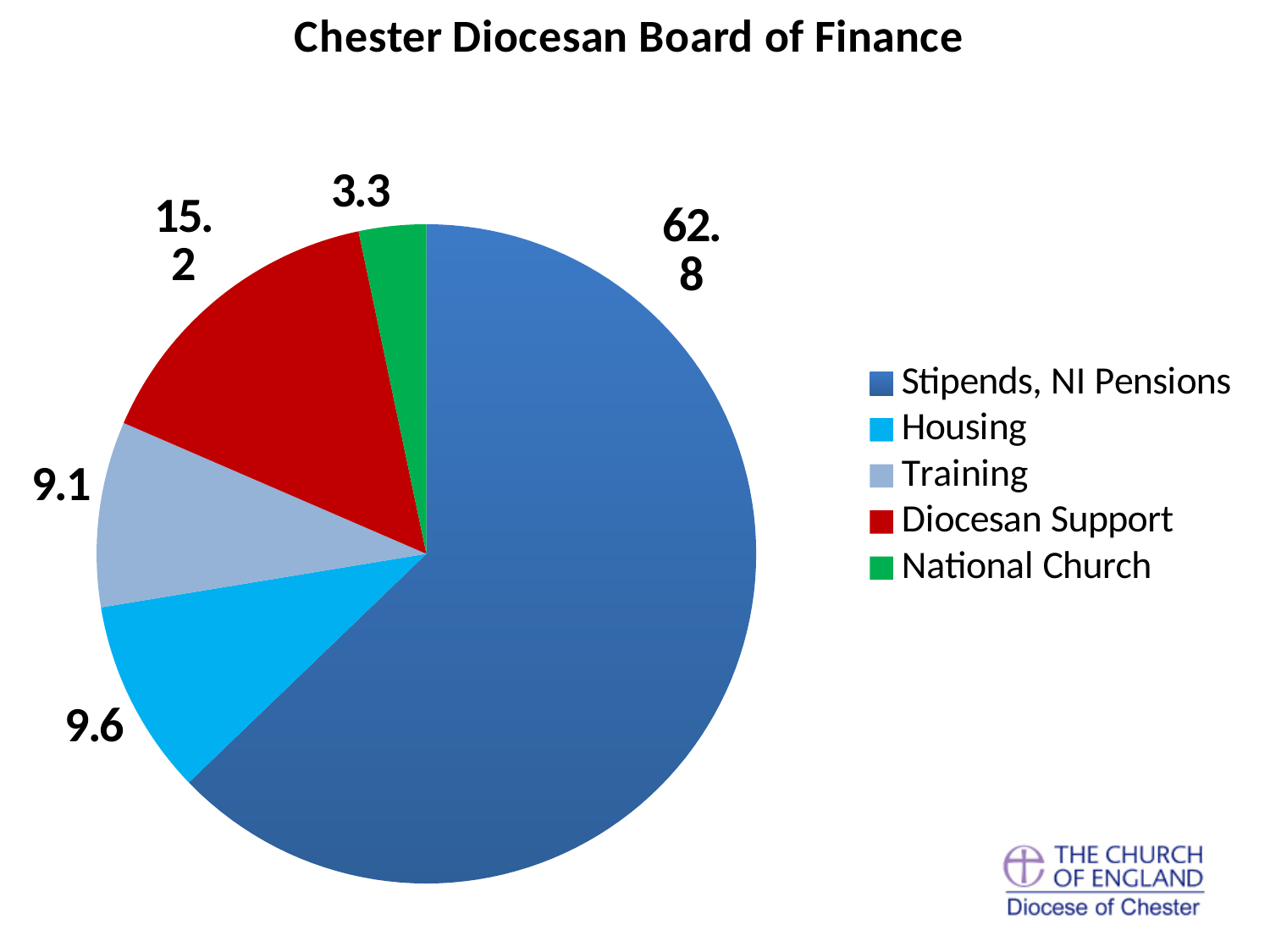
What is the value for Stipends, NI Pensions? 62.8 Which category has the largest slice of the pie? Stipends, NI Pensions What is the value for Housing? 9.6 Which is larger, the value for Diocesan Support or the value for Training? Diocesan Support What is the value for Diocesan Support? 15.2 What is the difference between the values for Diocesan Support and Housing? 5.6 What type of chart is shown on the slide? Pie chart How many categories does the legend list? 5 Which category has the smallest slice of the pie? National Church What is the value for Training? 9.1 What is the value for National Church? 3.3 What is the title of the chart? Chester Diocesan Board of Finance